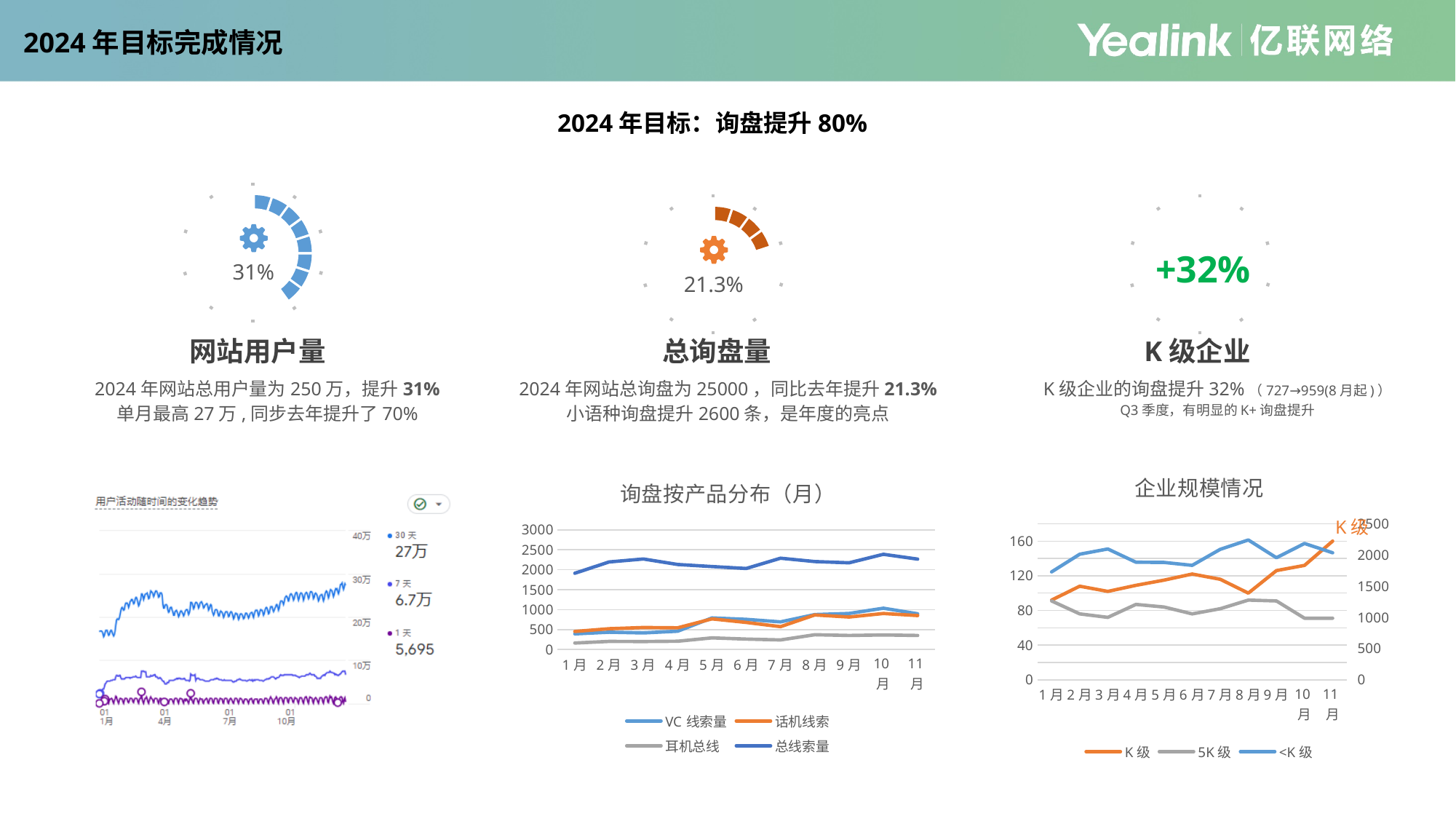
In the "询盘按产品分布（月）" chart, is the value of 耳机总线 for 5月 greater or less than 500? less In the "企业规模情况" chart, is the K 级 value for 11月 greater or less than 120 on the left axis? greater In the left chart titled "用户活动随时间的变化趋势", what value is shown for 30 天? 27万 How many months are shown on the x axis of the "询盘按产品分布（月）" chart? 11 How many series does the legend of the "企业规模情况" chart list? 3 In the "询盘按产品分布（月）" chart, which series has the highest values throughout the year? 总线索量 How many series does the legend of the "询盘按产品分布（月）" chart list? 4 In the "询盘按产品分布（月）" chart, which series has the lowest values across all months? 耳机总线 In the "企业规模情况" chart, does the K 级 line rise or fall from 8月 to 11月? rise In the left chart titled "用户活动随时间的变化趋势", what value is shown for 1 天? 5,695 In the "询盘按产品分布（月）" chart, is the value of 总线索量 for 10月 greater or less than 2000? greater What kind of chart is the "询盘按产品分布（月）" chart? line chart